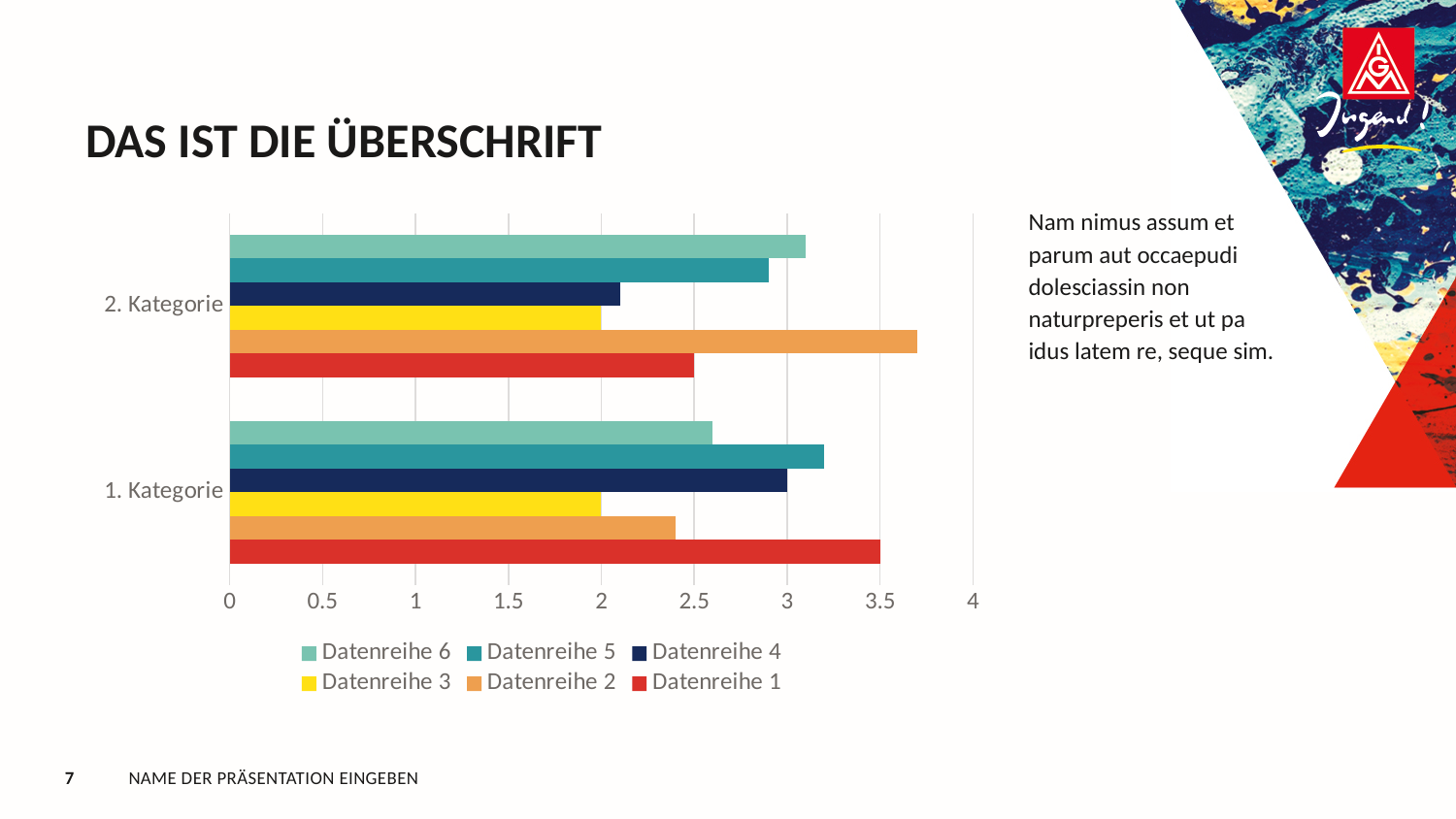
Is the value of Datenreihe 5 for 1. Kategorie greater or less than 3? greater How many series does the legend list? 6 Which is larger: Datenreihe 6 for 2. Kategorie or Datenreihe 6 for 1. Kategorie? 2. Kategorie How many categories are shown on the chart? 2 What is the title of the chart slide? DAS IST DIE ÜBERSCHRIFT Which series has the lowest value for 1. Kategorie? Datenreihe 3 Which series has the highest value for 2. Kategorie? Datenreihe 2 Is the value of Datenreihe 6 for 2. Kategorie greater or less than 3? greater Is the value of Datenreihe 2 for 1. Kategorie greater or less than 2.5? less Which series has the highest value for 1. Kategorie? Datenreihe 1 What kind of chart is shown on the slide? bar chart